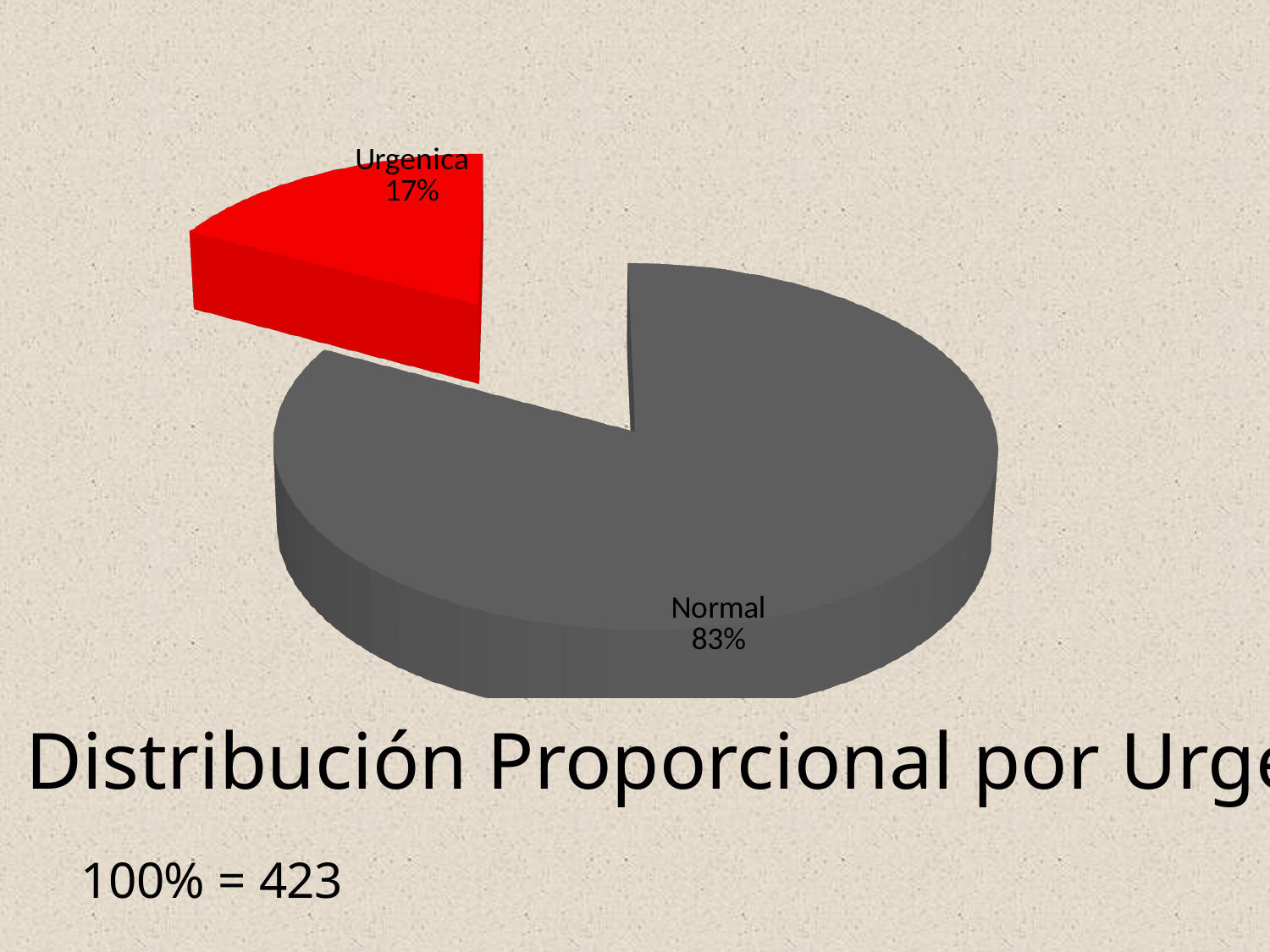
What colour is the Urgenica slice? Red According to the text below the chart, what total does 100% correspond to? 423 What kind of chart is shown on the slide? Pie chart What percentage does the Urgenica slice represent? 17% Which is larger, the Normal slice or the Urgenica slice? Normal What share of the pie does the Urgenica slice take? 17% Which slice is the smallest? Urgenica What percentage does the Normal slice represent? 83% Which slice is the largest? Normal How many slices does the pie chart have? 2 What is the difference in percentage points between the Normal and Urgenica slices? 66